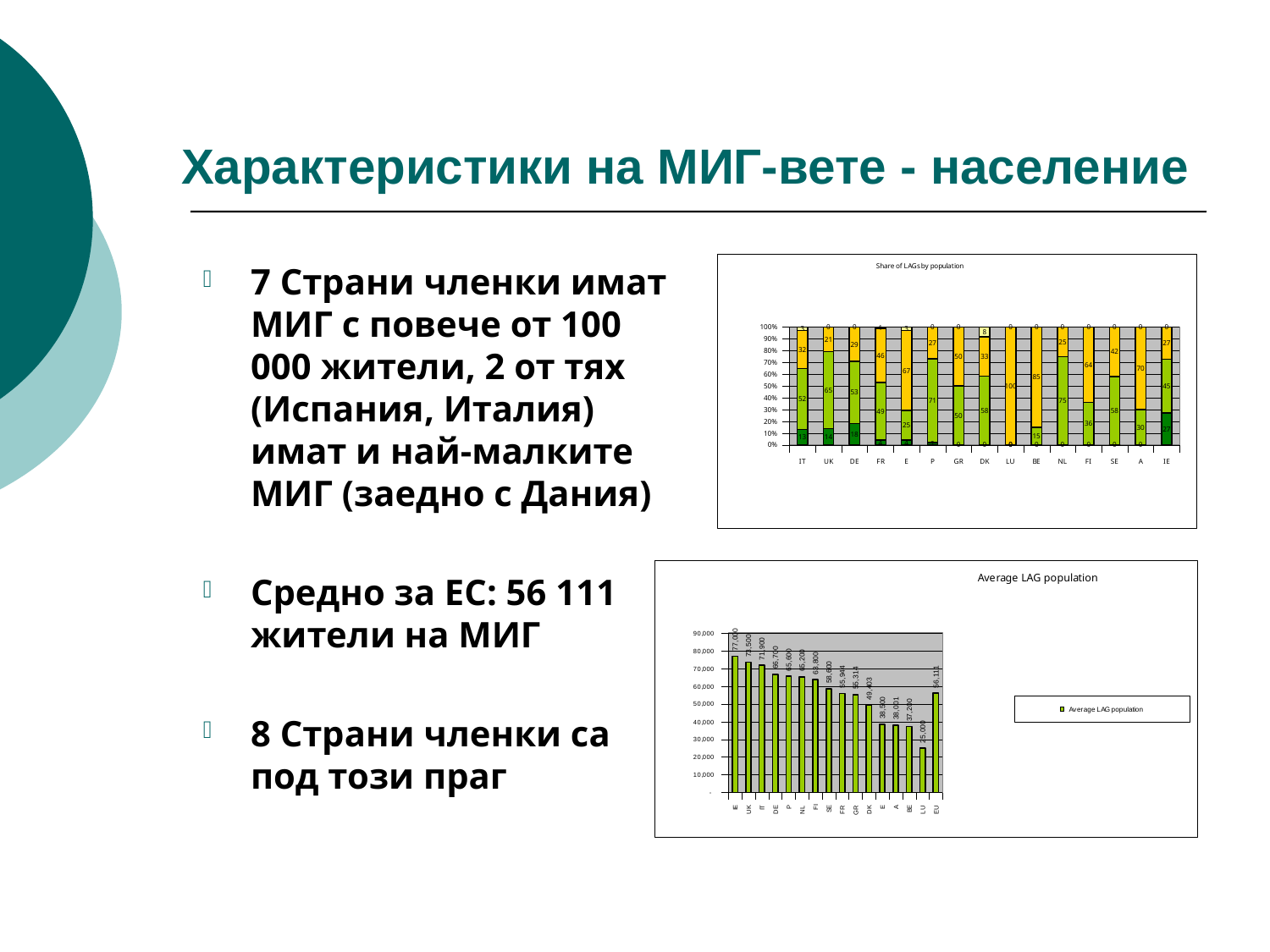
What kind of chart is the 'Share of LAGs by population' chart? stacked bar chart In the 'Average LAG population' chart, which is larger, the value for UK or the value for DK? UK In the 'Average LAG population' chart, is the value for DK greater or less than 40,000? greater In the 'Average LAG population' chart, what is the value for E? 38,500 In the 'Average LAG population' chart, what is the difference between the values for E and LU? 13,500 In the 'Average LAG population' chart, which category has the highest value? IE How many categories are shown on the x axis of the 'Share of LAGs by population' chart? 15 In the 'Average LAG population' chart, how many series does the legend list? 1 In the 'Average LAG population' chart, what is the value for LU? 25,000 What kind of chart is the 'Average LAG population' chart? bar chart In the 'Average LAG population' chart, what is the value for EU? 56,111 In the 'Average LAG population' chart, which category has the lowest value? LU